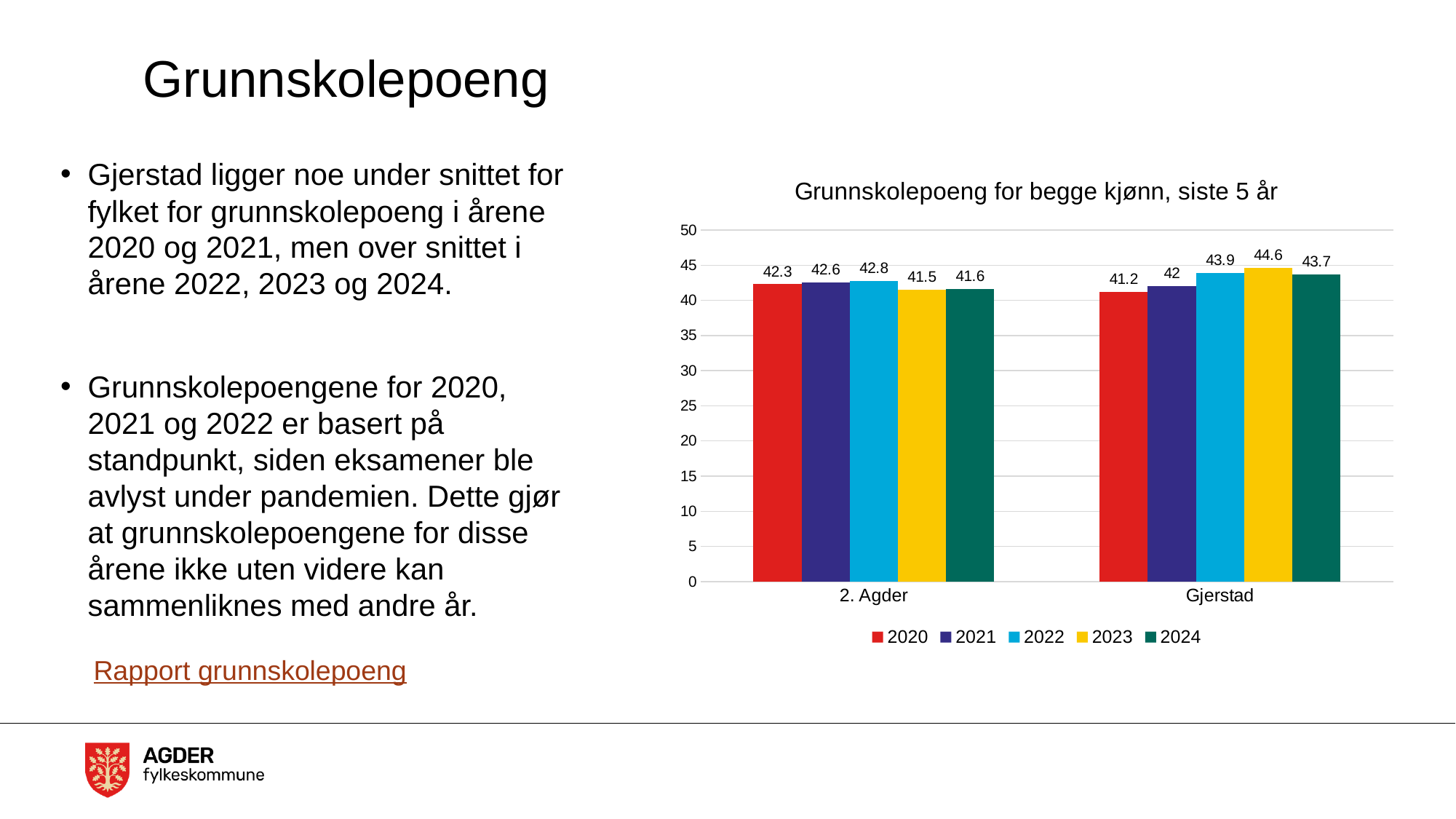
How many categories are shown on the x axis? 2 What is the title of the chart? Grunnskolepoeng for begge kjønn, siste 5 år What is the difference between Gjerstad and 2. Agder in 2023? 3.1 Which year has the highest value for Gjerstad? 2023 What is the value for Gjerstad in 2023? 44.6 Which is larger in 2021, the value for 2. Agder or for Gjerstad? 2. Agder What kind of chart is shown? Bar chart How many series does the legend list? 5 Is the value for Gjerstad in 2024 greater or less than 40? greater Which year has the lowest value for 2. Agder? 2023 What is the value for Gjerstad in 2020? 41.2 What is the value for 2. Agder in 2022? 42.8